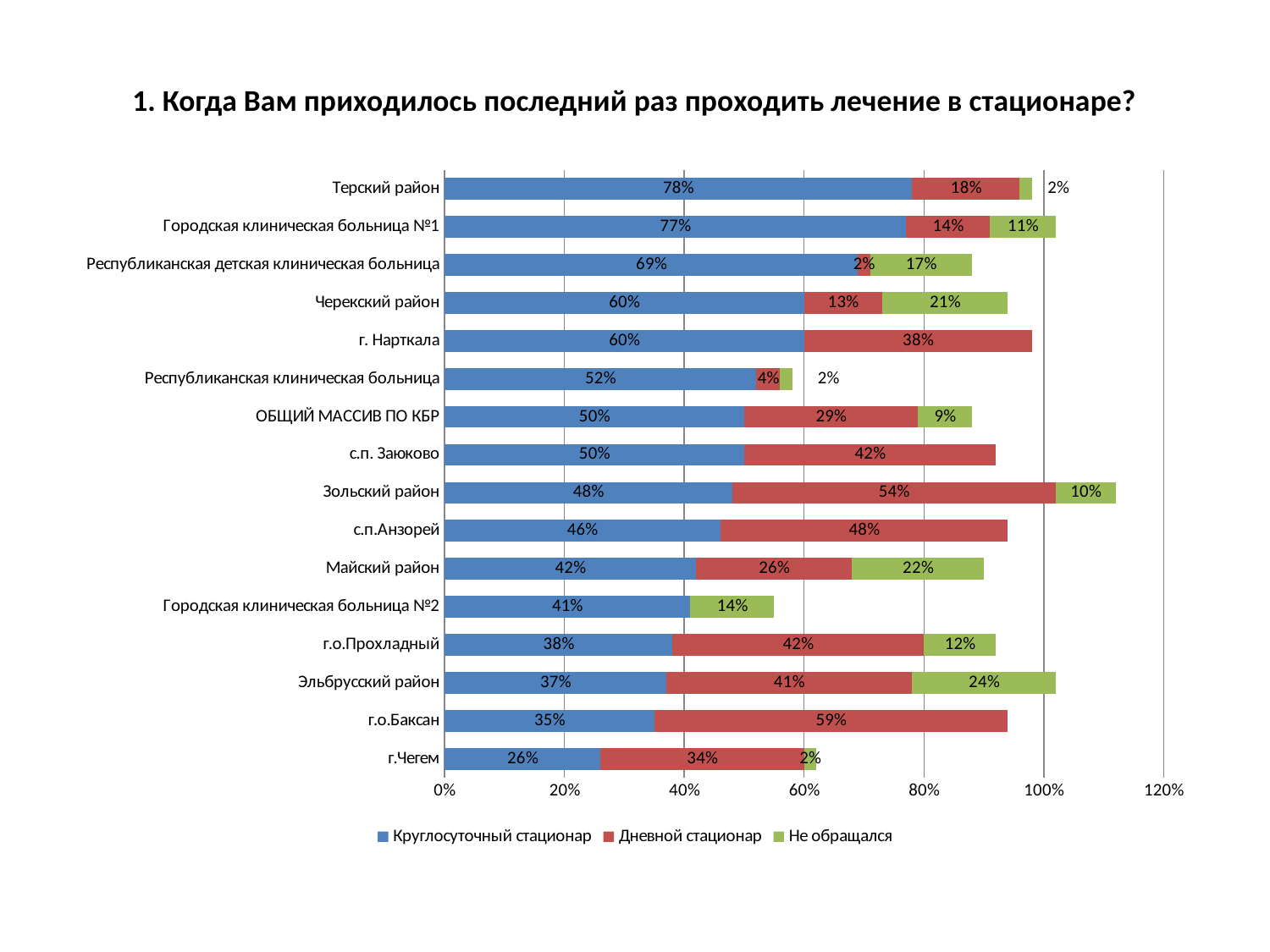
What is the value of Дневной стационар for ОБЩИЙ МАССИВ ПО КБР? 29% What is the value of Круглосуточный стационар for Терский район? 78% What is the value of Дневной стационар for г.о.Баксан? 59% How many series does the legend list? 3 Which is larger: Дневной стационар for Зольский район or for г.о.Баксан? г.о.Баксан How many categories are shown on the chart? 16 What is the total of the stacked bar for Черекский район? 94% Which category has the lowest value for Круглосуточный стационар? г.Чегем For Майский район, what is the difference between Круглосуточный стационар and Дневной стационар? 16 percentage points What is the value of Не обращался for Эльбрусский район? 24% Which category has the highest value for Дневной стационар? г.о.Баксан Which category has the highest value for Круглосуточный стационар? Терский район